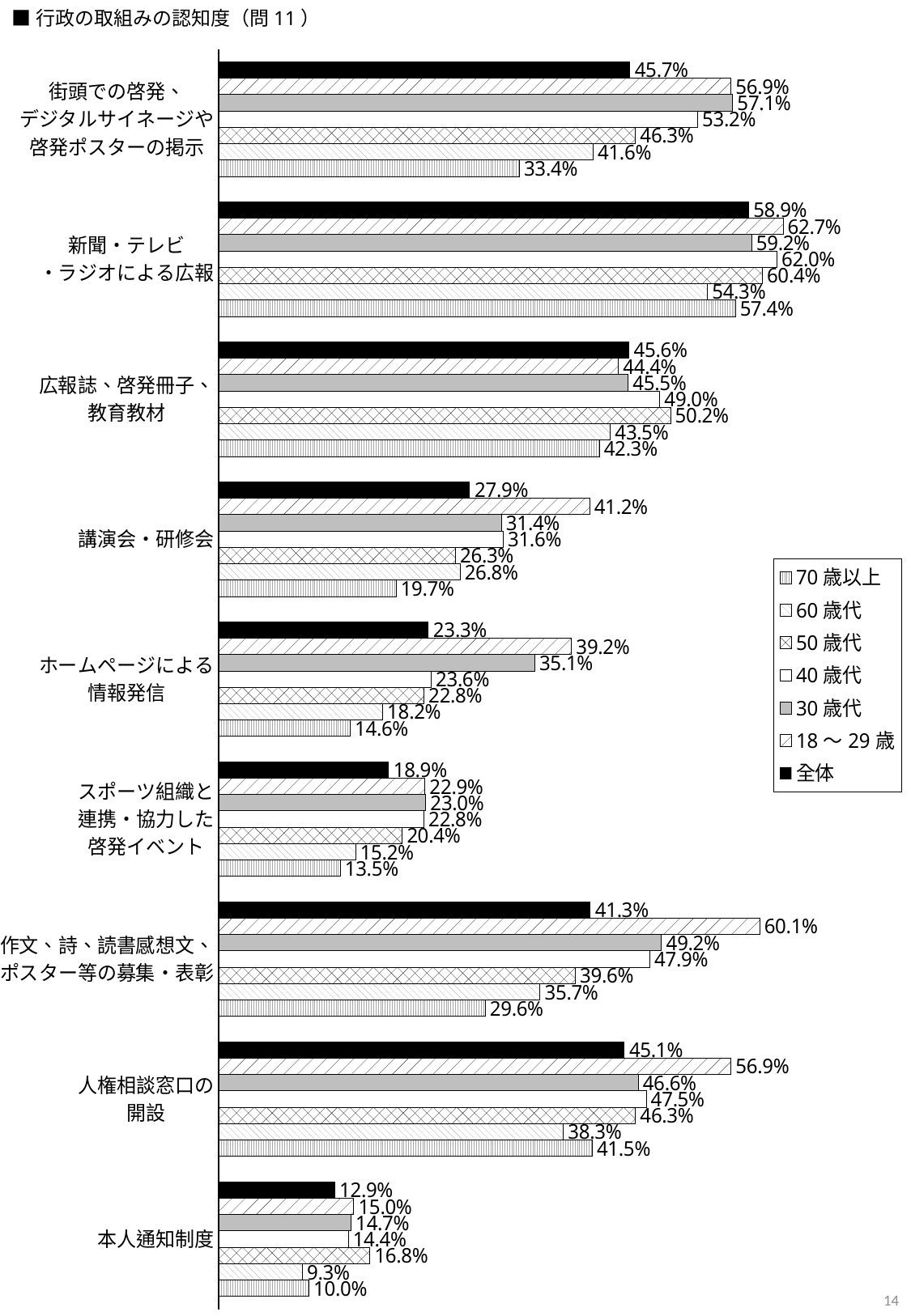
For ホームページによる情報発信, which age group has the highest value? 18～29歳 For 作文、詩、読書感想文、ポスター等の募集・表彰, what is the difference between the 18～29歳 value and the 70歳以上 value? 30.5 percentage points Which category has the lowest value for 全体? 本人通知制度 What kind of chart is shown on the slide? Bar chart How many series does the legend list? 7 Which series is shown with solid black bars? 全体 How many categories are shown on the chart? 9 Which category has the highest value for 全体? 新聞・テレビ・ラジオによる広報 What is the value for 50歳代 for 広報誌、啓発冊子、教育教材? 50.2% What is the value for 70歳以上 for 本人通知制度? 10.0% For 講演会・研修会, which is larger: the value for 18～29歳 or the value for 30歳代? 18～29歳 What is the value for 全体 for 新聞・テレビ・ラジオによる広報? 58.9%